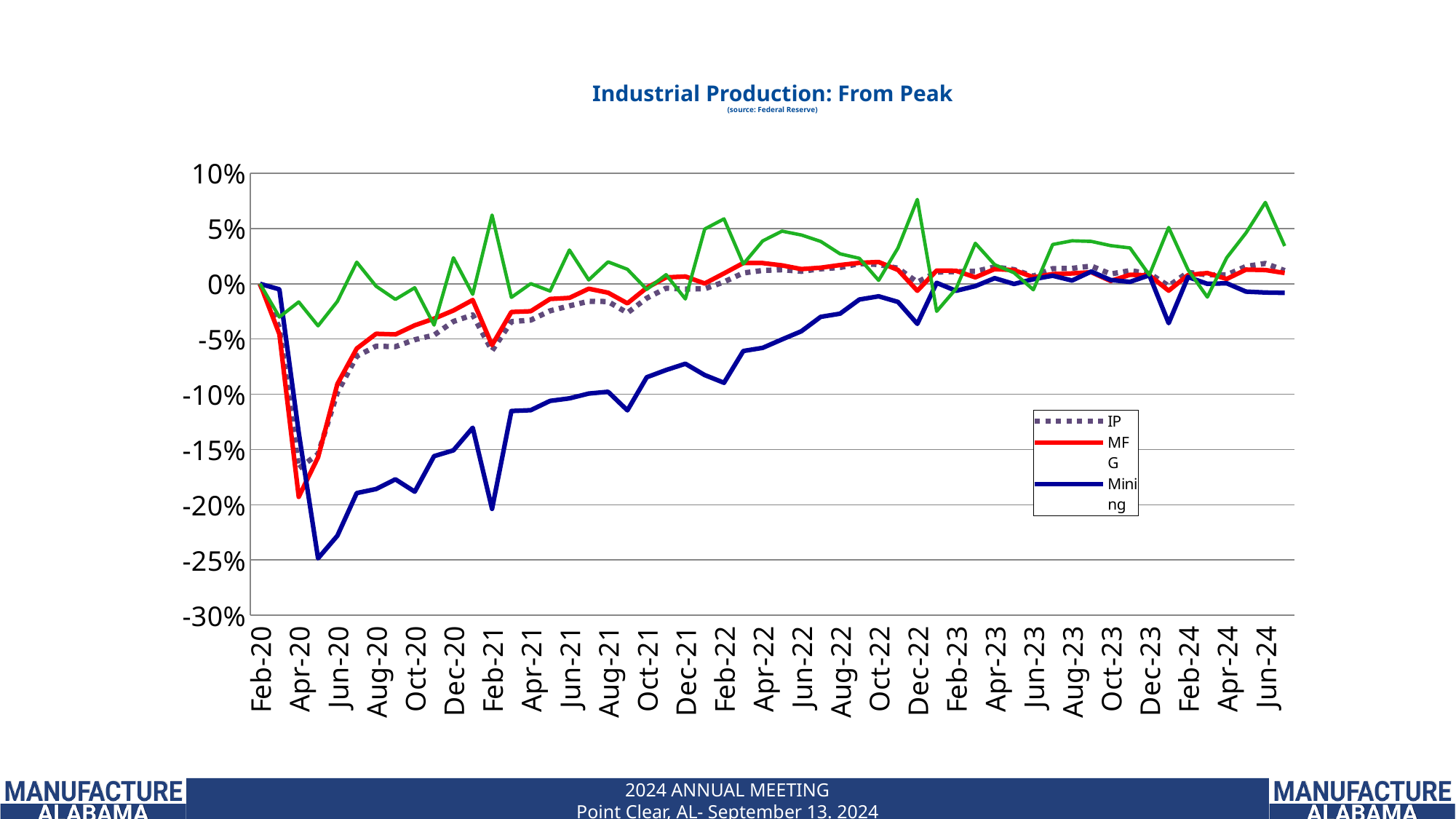
What kind of chart is shown on the slide? Line chart Is the value of the Mining series at Oct-21 greater or less than -5%? less From Apr-20 to Jun-24, does the Mining series generally rise or fall? rise Is the value of the Mining series at Feb-21 greater or less than -15%? less What is the title of the chart? Industrial Production: From Peak Is the lowest value of the MFG series greater or less than -15%? less How many series does the chart's legend list? 3 Which series listed in the legend reaches the lowest value on the chart? Mining At Feb-21, which series has the larger value, MFG or Mining? MFG What source is cited beneath the chart title? Federal Reserve